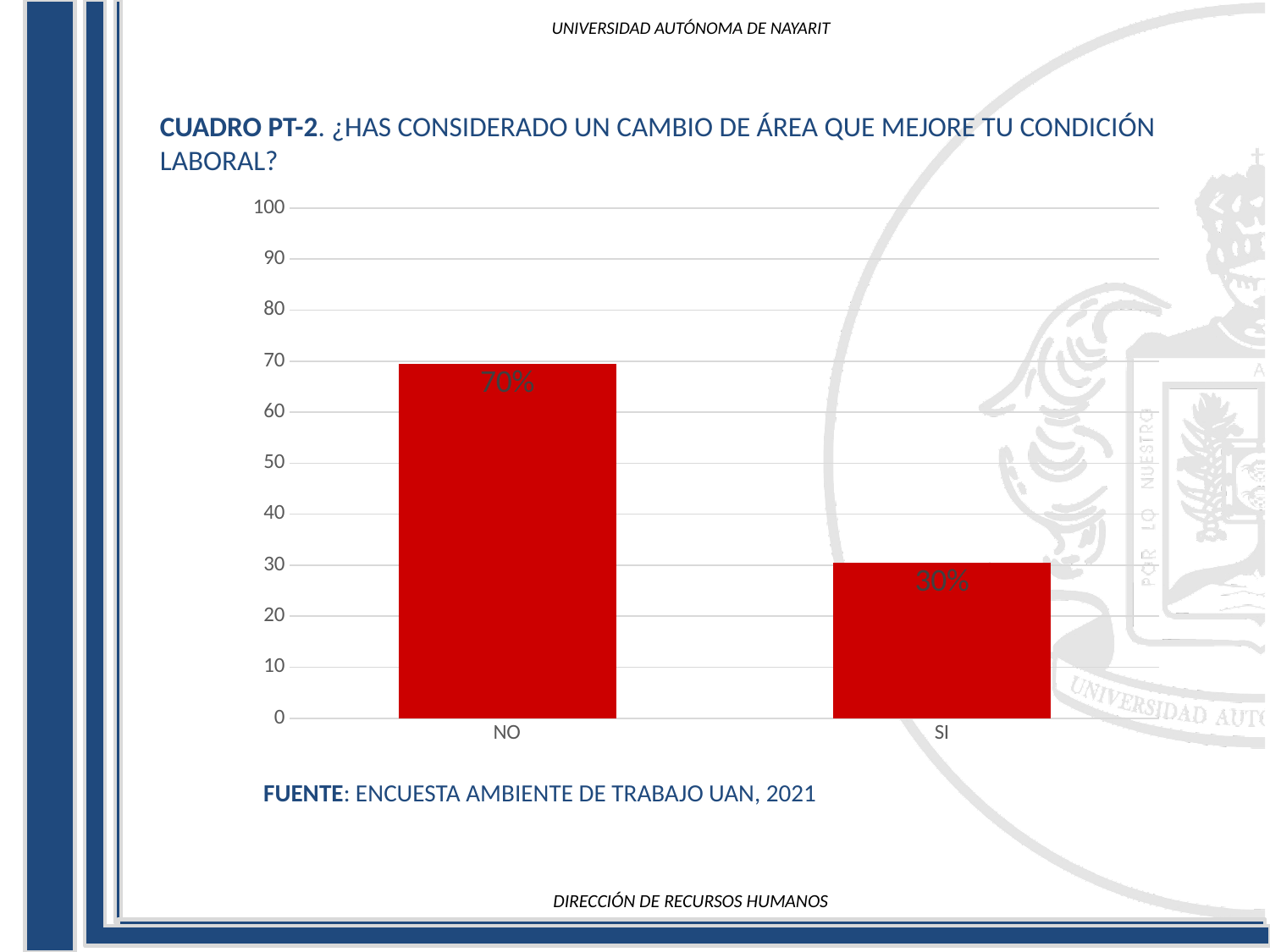
What colour are the bars in the chart? red What is the difference between the values for NO and SI? 40% Is the value for SI greater or less than 40? less Which category has the highest value? NO Which is larger, the value for NO or the value for SI? NO What is the value for SI? 30% What is the source cited below the chart? ENCUESTA AMBIENTE DE TRABAJO UAN, 2021 What kind of chart is shown on the slide? bar chart How many categories are shown on the x axis? 2 What is the value for NO? 70% Which category has the lowest value? SI Is the value for NO greater or less than 50? greater